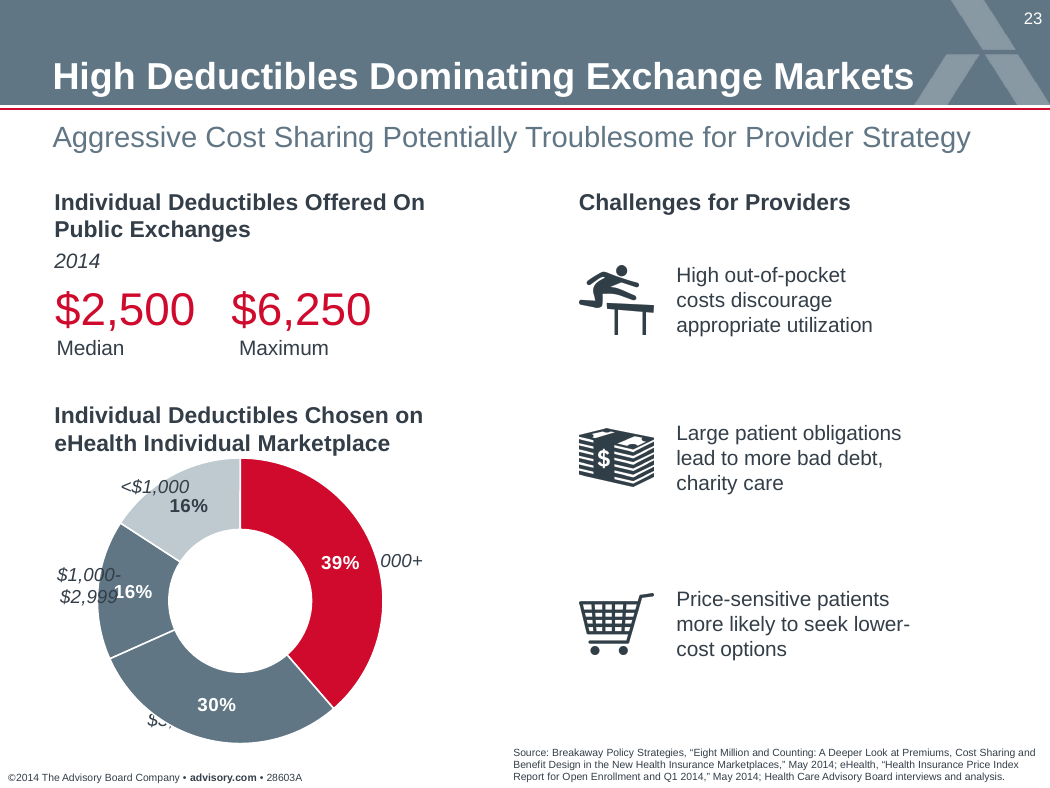
In the donut chart, is the share for <$1,000 larger than, smaller than, or equal to the share for $1,000-$2,999? equal What is the smallest percentage shown in the donut chart? 16% How many slices does the donut chart have? 4 What colour is the largest slice (39%) in the donut chart? red What kind of chart is shown under "Individual Deductibles Chosen on eHealth Individual Marketplace"? pie (donut) chart In the donut chart, what is the difference between the largest slice (39%) and the <$1,000 slice? 23% In the donut chart, what share of individual deductibles chosen were in the $1,000-$2,999 range? 16% What is the largest percentage shown in the donut chart? 39% In the donut chart, what share of individual deductibles chosen were <$1,000? 16% In the donut chart, what is the difference between the 39% slice and the 30% slice? 9% In the donut chart, what is the combined share of the <$1,000 and $1,000-$2,999 slices? 32% What is the title of the donut chart on the slide? Individual Deductibles Chosen on eHealth Individual Marketplace